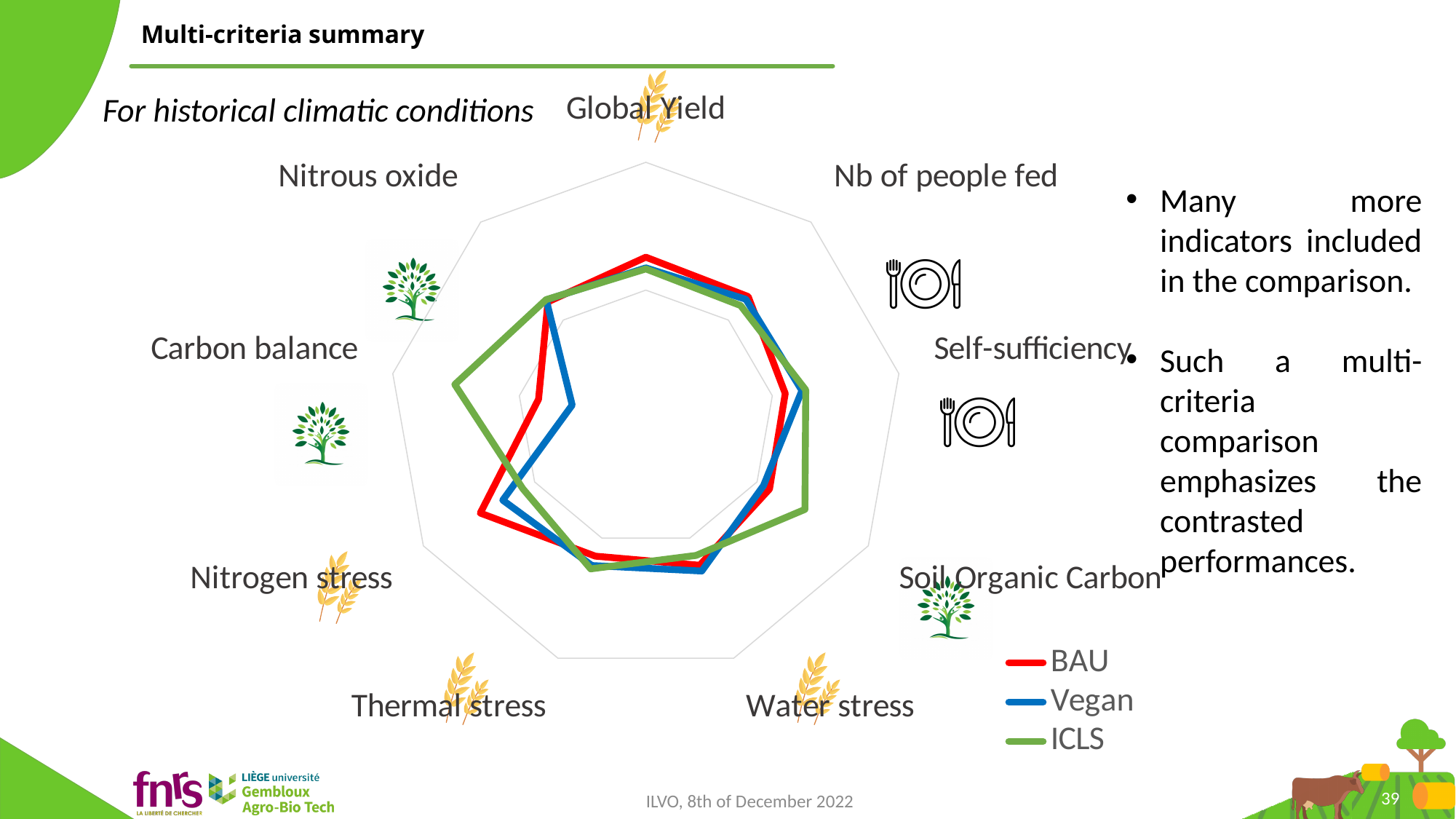
How many series does the legend of the radar chart list? 3 On the Carbon balance axis, which series extends furthest from the centre? ICLS On the Self-sufficiency axis, is the value for ICLS larger or smaller than the value for BAU? larger On the Carbon balance axis, is the value for ICLS larger or smaller than the value for Vegan? larger What kind of chart is shown on the slide? Radar chart On the Nitrogen stress axis, which series extends furthest from the centre? BAU On the Soil Organic Carbon axis, which series extends furthest from the centre? ICLS On the Nitrogen stress axis, is the value for BAU larger or smaller than the value for ICLS? larger How many indicators (axes) does the radar chart compare? 9 On the Nitrogen stress axis, which series is closest to the centre? ICLS Which series is drawn in red on the radar chart? BAU Which series is drawn in green on the radar chart? ICLS